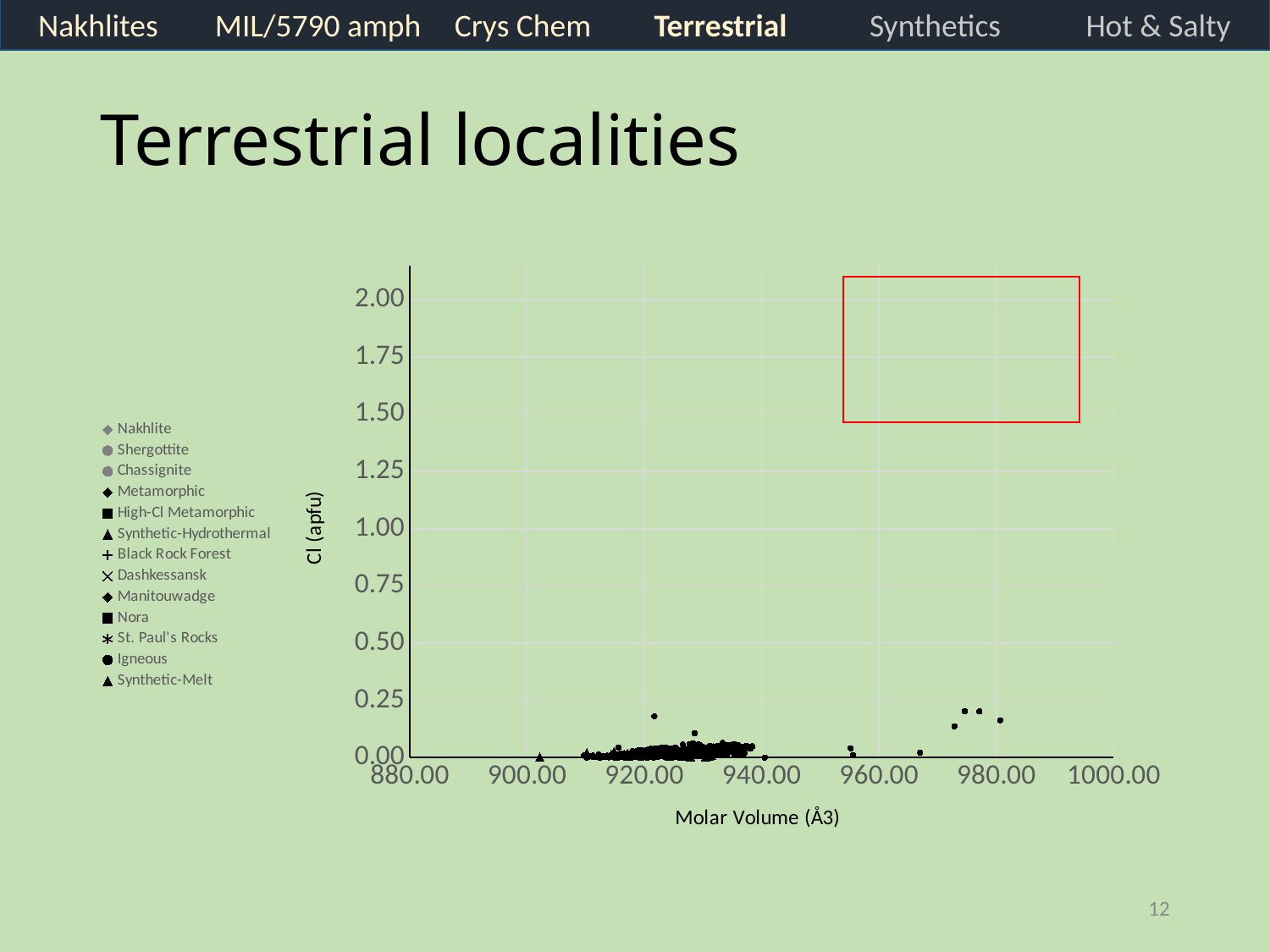
Are all the plotted Cl (apfu) values in the chart greater or less than 1.00? less What is the highest tick value shown on the y axis of the chart? 2.00 Is the Molar Volume of the densest cluster of points in the chart greater or less than 960.00? less What is the title of the slide containing the chart? Terrestrial localities How many series does the legend of the chart list? 13 What is the highest tick value shown on the x axis of the chart? 1000.00 Is the Molar Volume of the small group of points near the right side of the chart greater or less than 960.00? greater What kind of chart is shown on the slide? scatter chart What is the lowest tick value shown on the x axis of the chart? 880.00 What is the label of the y axis of the chart? Cl (apfu)